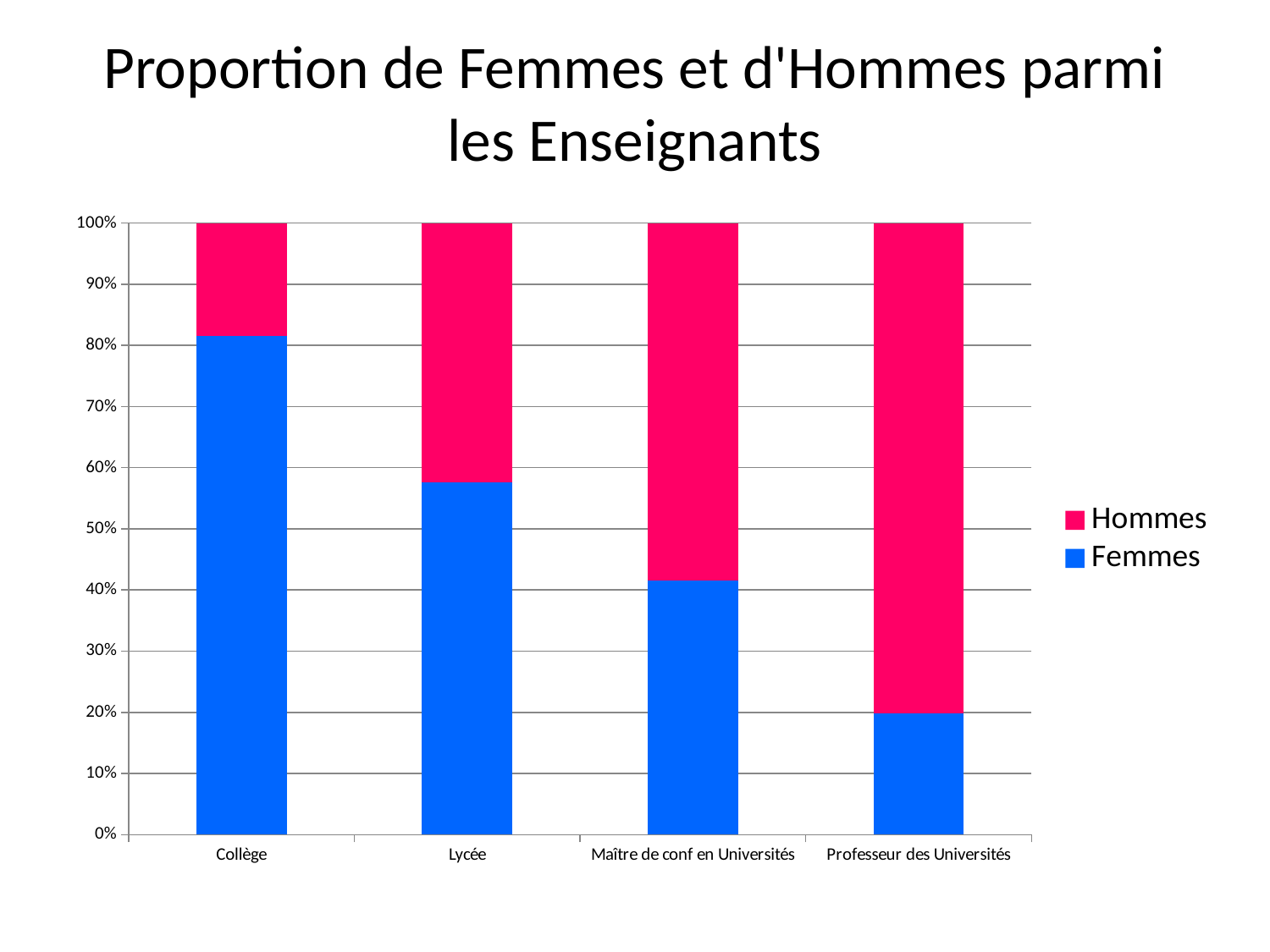
Is the Femmes value for Professeur des Universités greater or less than 30%? less What kind of chart is shown on the slide? Stacked bar chart How many series does the legend list? 2 Which category has the highest proportion of Femmes? Collège Is the Femmes value for Lycée greater or less than 50%? greater Does the proportion of Femmes rise or fall from Collège to Professeur des Universités along the x axis? fall Which category has the highest proportion of Hommes? Professeur des Universités Which category has the lowest proportion of Femmes? Professeur des Universités Which series is shown in blue in the legend? Femmes Is the Femmes value for Collège greater or less than 70%? greater How many categories are shown on the x axis? 4